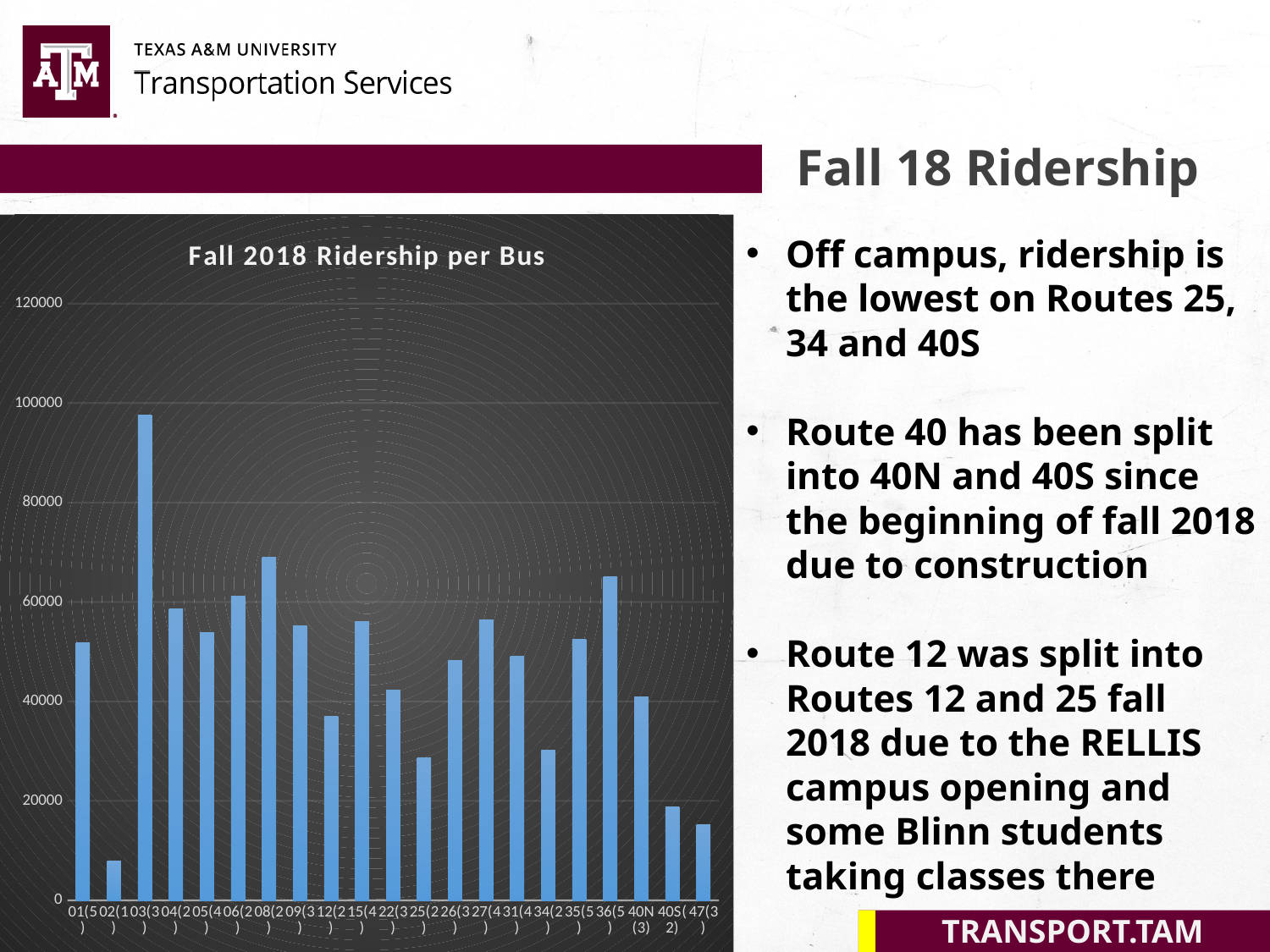
How many bars (bus routes) are plotted in the chart? 21 Which route has higher ridership, 36 or 40S? 36 What is the highest value shown on the vertical axis? 120000 Is the ridership for route 08 greater or less than 60000? greater Is the ridership for route 40S greater or less than 20000? less What kind of chart is shown on the slide? bar chart Which route has the lowest ridership in the chart? 02 Is the ridership for route 02 greater or less than 20000? less What is the title of the chart? Fall 2018 Ridership per Bus Which route has higher ridership, 25 or 06? 06 Which route has the highest ridership in the chart? 03